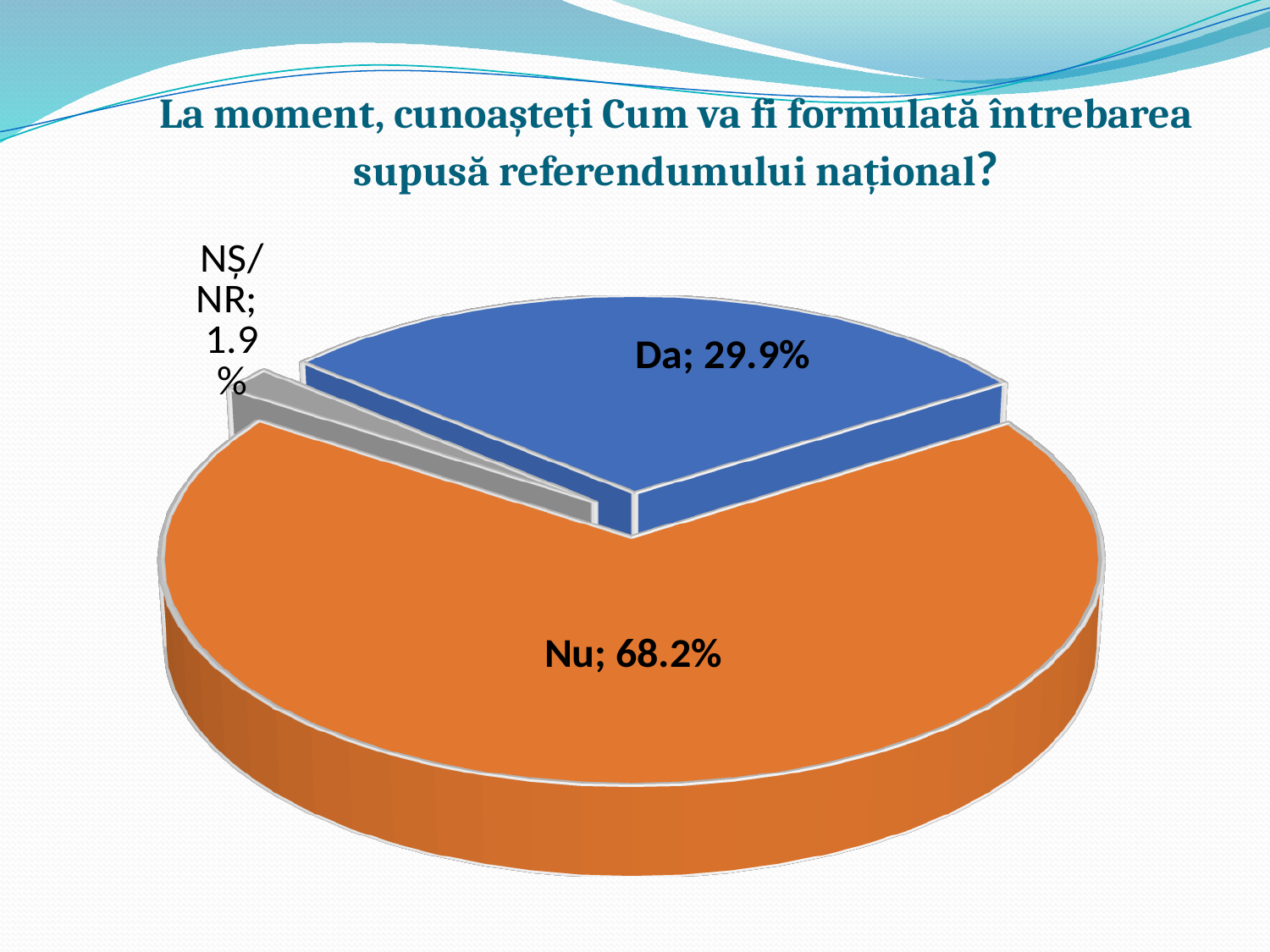
Which slice of the pie is the largest? Nu How many slices does the pie chart have? 3 What percentage of respondents answered "Nu"? 68.2% What colour is the "Nu" slice? orange Which is larger, the "Da" slice or the "NȘ/NR" slice? Da What is the difference in percentage points between the "Nu" and "Da" slices? 38.3 What percentage is shown for the "NȘ/NR" slice? 1.9% What colour is the "Da" slice? blue What percentage of respondents answered "Da"? 29.9% Which slice of the pie is the smallest? NȘ/NR What kind of chart is shown on the slide? pie chart What is the combined share of the "Da" and "NȘ/NR" slices? 31.8%